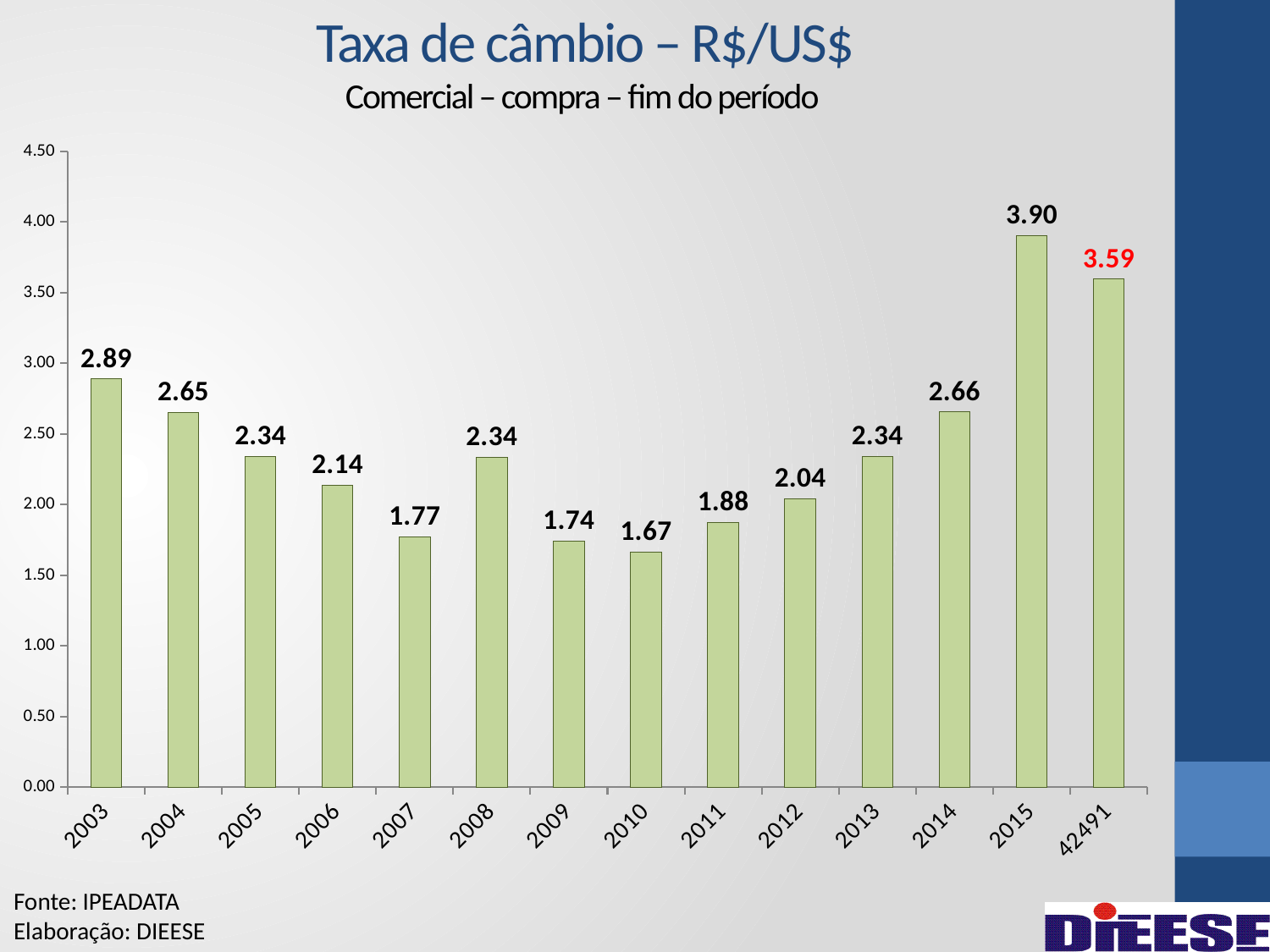
Which year has the lowest exchange rate value? 2010 What is the value shown for 2010? 1.67 Which is larger, the value for 2004 or the value for 2012? 2004 What is the exchange rate value shown for 2003? 2.89 Do the values rise or fall from 2010 to 2015? Rise What is the difference between the values for 2015 and 2014? 1.24 How many bars are plotted in the chart? 14 What is the title of the chart? Taxa de câmbio – R$/US$ What is the value shown for 2015? 3.90 What is the value shown for the last bar, labelled 42491? 3.59 What kind of chart is shown on the slide? Bar chart Which year has the highest exchange rate value? 2015